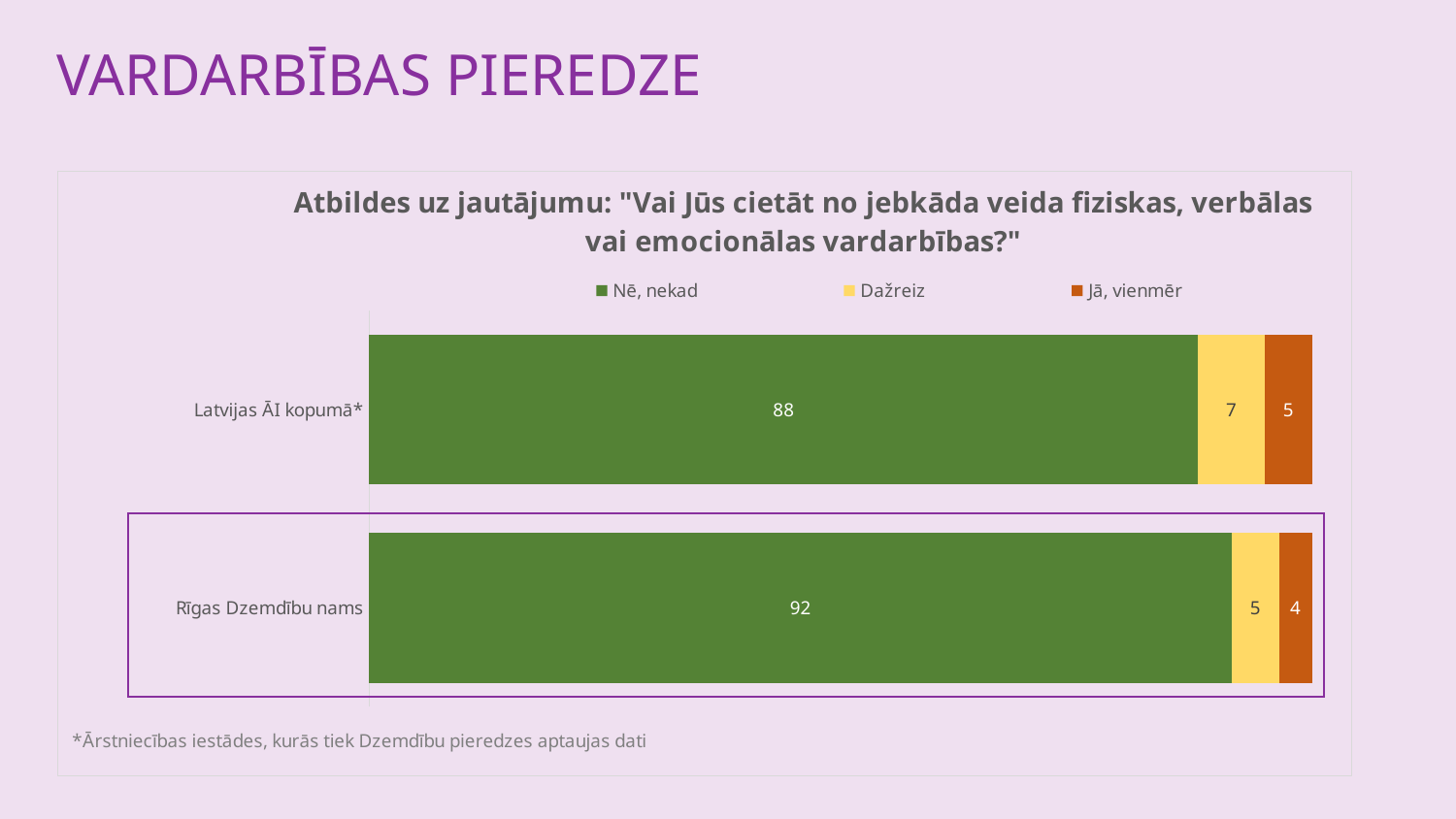
Which category has the lower value for "Jā, vienmēr"? Rīgas Dzemdību nams What is the value for "Jā, vienmēr" for Latvijas ĀI kopumā*? 5 What kind of chart is shown on the slide? Stacked bar chart Which category has the higher value for "Nē, nekad"? Rīgas Dzemdību nams What is the total of the stacked bar for Latvijas ĀI kopumā*? 100 How many series does the legend list? 3 What is the value for "Nē, nekad" for Latvijas ĀI kopumā*? 88 What is the value for "Nē, nekad" for Rīgas Dzemdību nams? 92 What is the difference between the "Nē, nekad" values for Rīgas Dzemdību nams and Latvijas ĀI kopumā*? 4 What is the value for "Dažreiz" for Rīgas Dzemdību nams? 5 How many categories are shown on the chart? 2 Is the "Dažreiz" value larger for Latvijas ĀI kopumā* or for Rīgas Dzemdību nams? Latvijas ĀI kopumā*